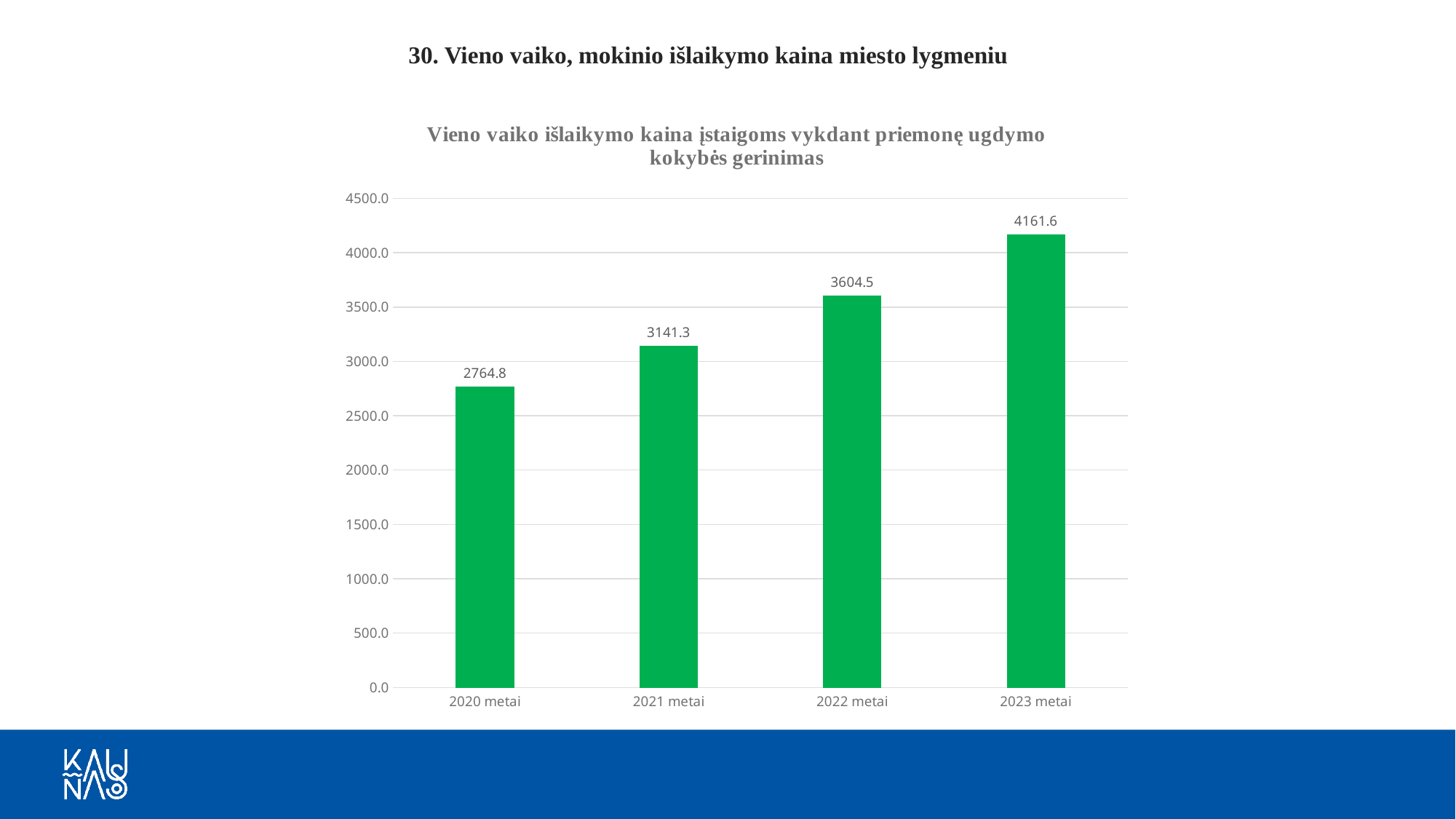
Which year has the highest value? 2023 metai Is the value for 2023 metai greater or less than 4000.0? greater What is the difference between the values for 2023 metai and 2022 metai? 557.1 What is the value for 2021 metai? 3141.3 How many years are shown on the x axis? 4 Which year has the lowest value? 2020 metai What is the value for 2020 metai? 2764.8 What is the difference between the values for 2021 metai and 2020 metai? 376.5 What is the value for 2022 metai? 3604.5 Which is larger, the value for 2021 metai or the value for 2022 metai? 2022 metai What is the value for 2023 metai? 4161.6 What kind of chart is shown? bar chart